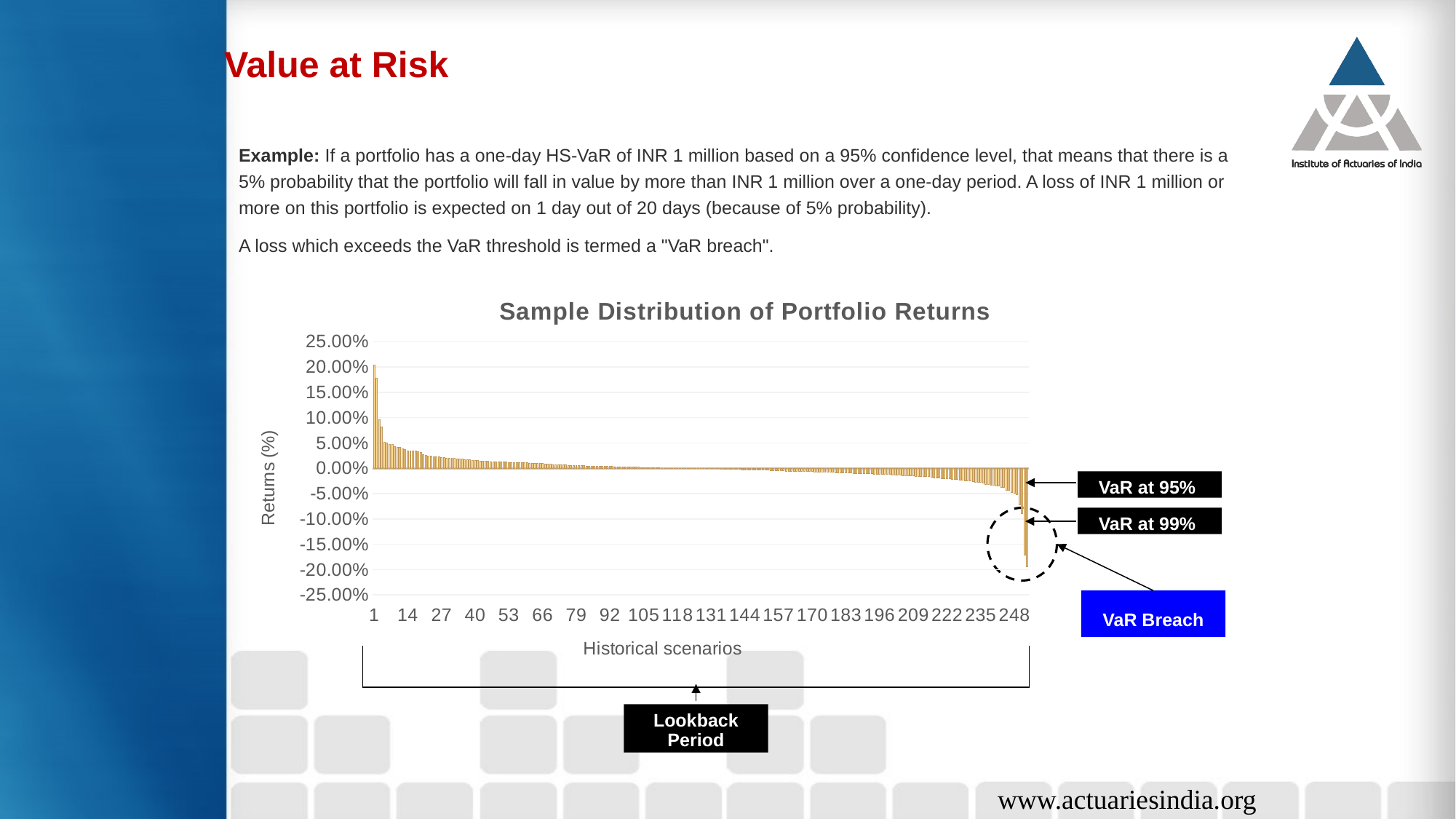
Is the lowest bar in the chart greater or less than -15.00%? less Is the return for historical scenario 14 greater or less than 10.00%? less What is the label of the y axis of the chart? Returns (%) Is the return for historical scenario 235 greater or less than -5.00%? greater Do the bar values rise or fall as you move from left to right along the x axis? fall Which is larger, the return for historical scenario 27 or the return for historical scenario 209? historical scenario 27 What kind of chart is shown on the slide? bar chart What is the title of the chart? Sample Distribution of Portfolio Returns Which historical scenario has the highest return in the chart? 1